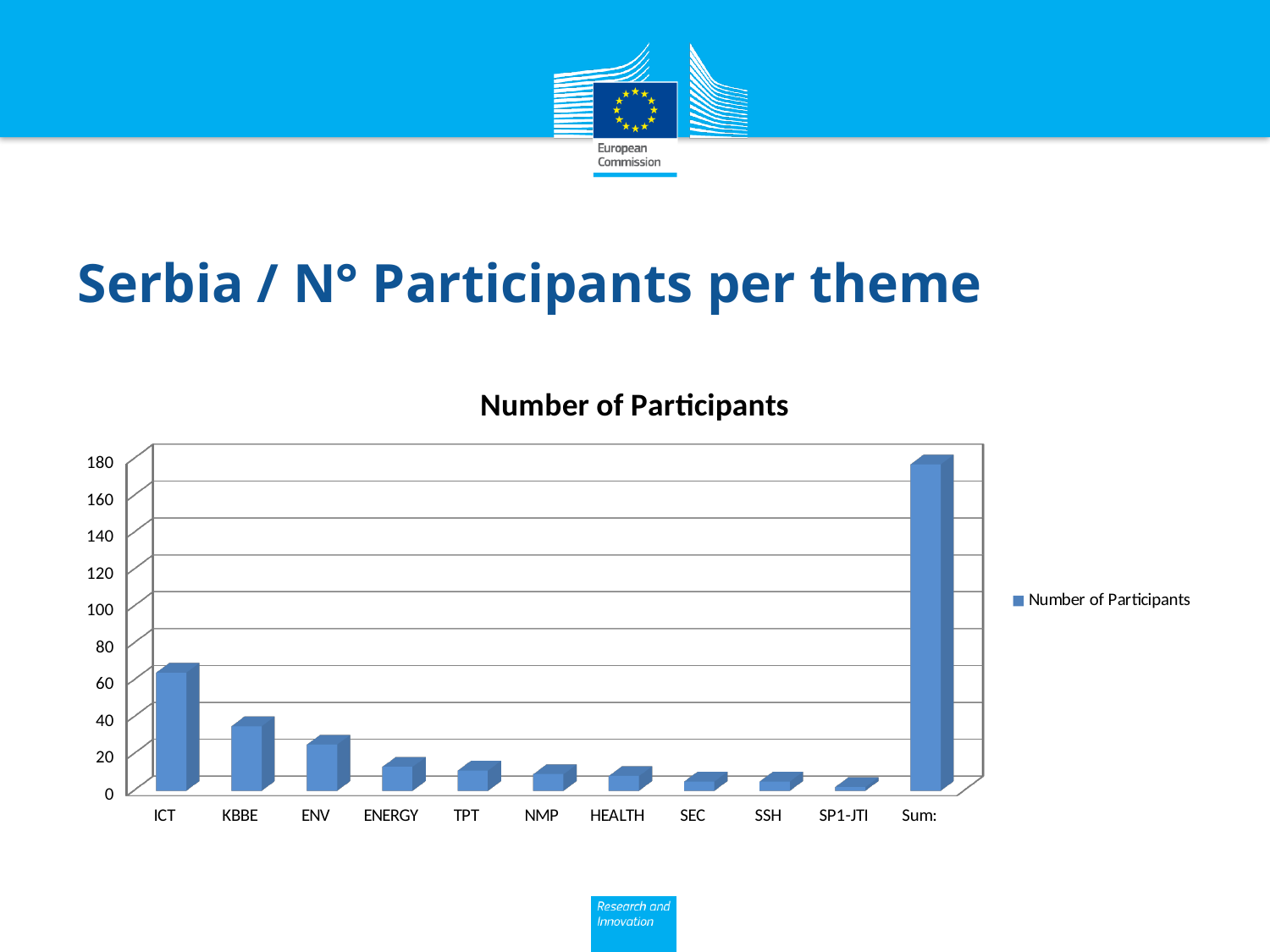
How many categories are shown on the x axis of the chart? 11 What is the title of the chart? Number of Participants How many series does the legend list? 1 Do the values rise or fall along the x axis from ICT to SP1-JTI? fall Excluding the Sum: bar, which theme has the most participants? ICT Is the value for ICT greater or less than 40? greater Which has more participants, ICT or KBBE? ICT Which category has the highest bar in the chart? Sum: Is the value for Sum: greater or less than 160? greater Which category has the lowest bar in the chart? SP1-JTI What kind of chart is shown on the slide? bar chart Is the value for ENERGY greater or less than 20? less